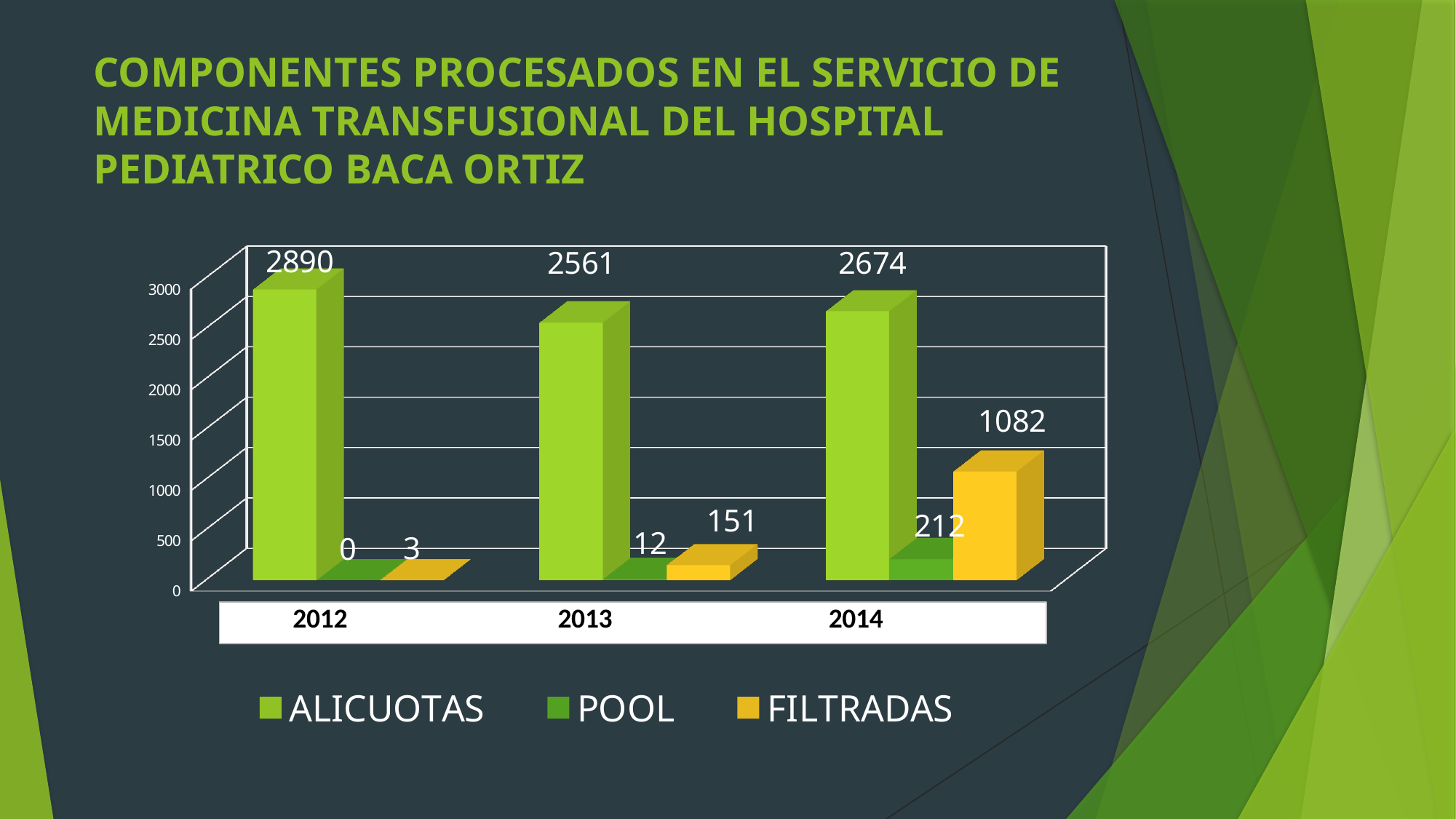
How many years are shown on the x axis? 3 How many series does the legend list? 3 What is the difference between the ALICUOTAS values for 2012 and 2013? 329 What is the value for POOL in 2013? 12 What kind of chart is shown on the slide? bar chart What is the value for FILTRADAS in 2012? 3 In which year is the POOL value lowest? 2012 Is the ALICUOTAS value for 2014 greater or less than 2500? greater Which is larger, the FILTRADAS value in 2013 or the POOL value in 2014? POOL value in 2014 What is the value for FILTRADAS in 2014? 1082 What is the value for ALICUOTAS in 2012? 2890 In which year is the ALICUOTAS value highest? 2012